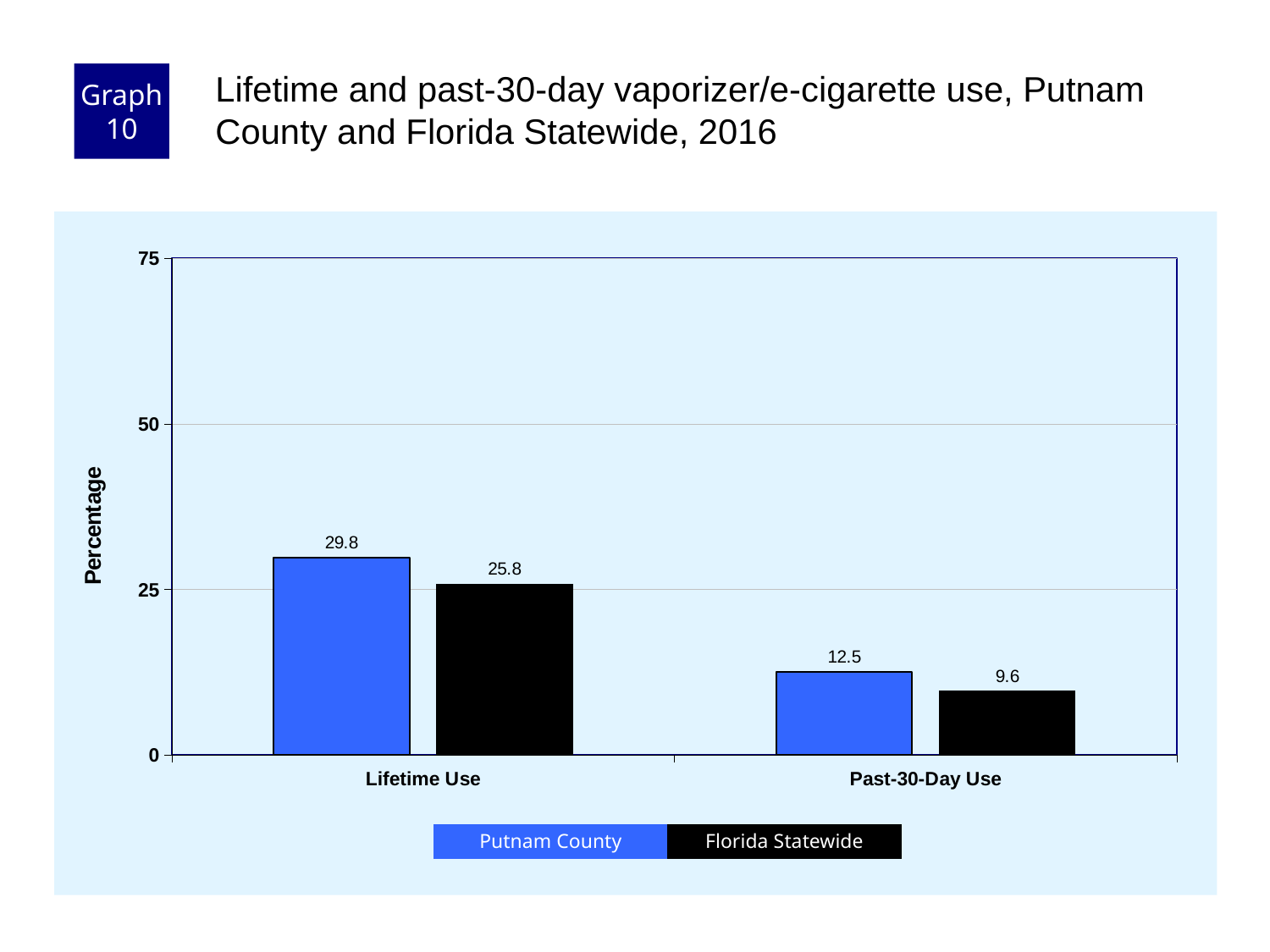
What is the Florida Statewide value for Lifetime Use? 25.8 Which category has the highest Putnam County value? Lifetime Use Is the Putnam County value for Lifetime Use greater or less than 25? greater For Past-30-Day Use, which is larger: Putnam County or Florida Statewide? Putnam County What is the Putnam County value for Lifetime Use? 29.8 What is the Putnam County value for Past-30-Day Use? 12.5 Which category has the lowest Florida Statewide value? Past-30-Day Use What is the difference between the Putnam County and Florida Statewide values for Lifetime Use? 4.0 What is the difference between the Putnam County and Florida Statewide values for Past-30-Day Use? 2.9 What is the Florida Statewide value for Past-30-Day Use? 9.6 What kind of chart is shown on the slide? Bar chart How many series does the legend list? 2